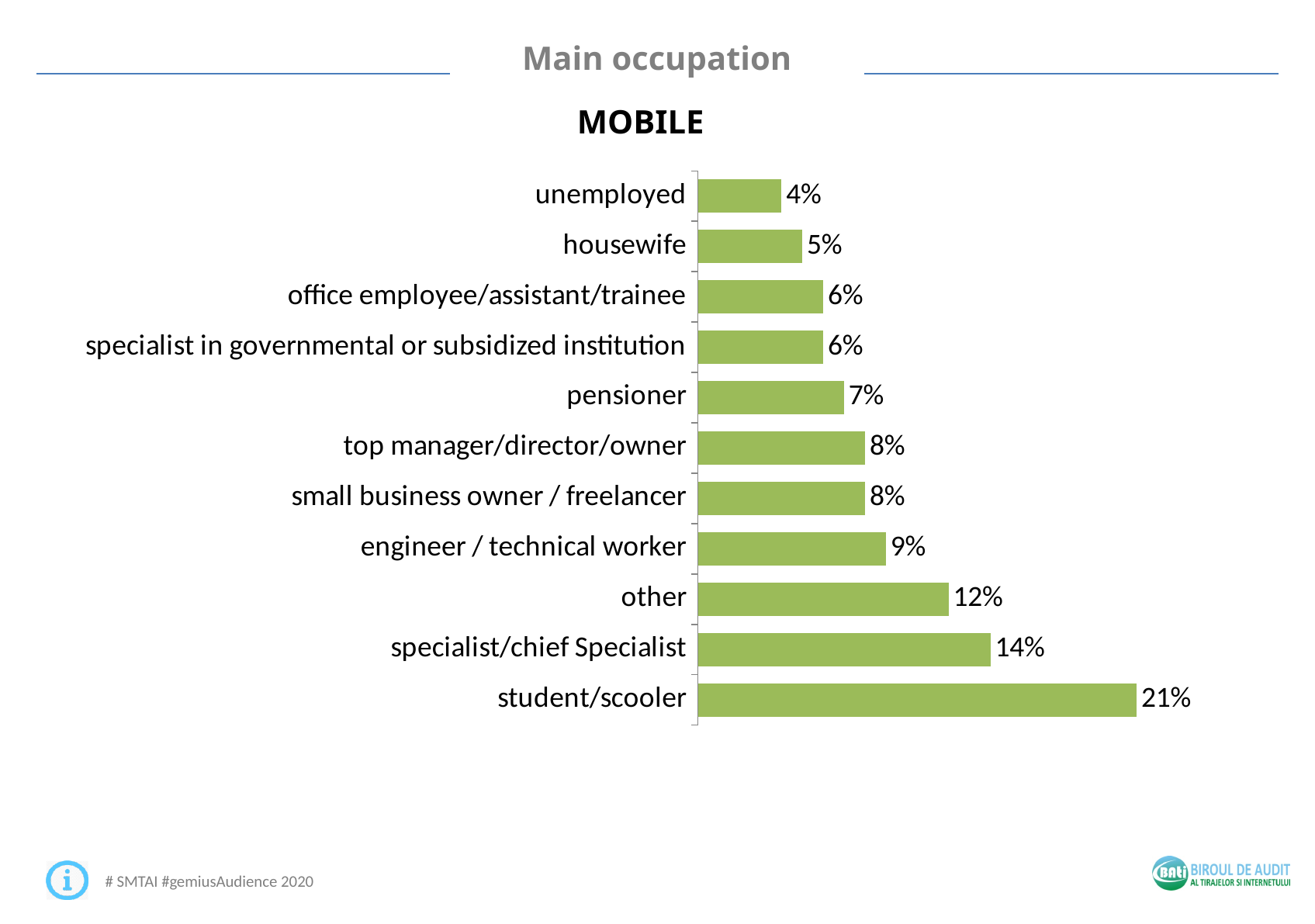
What kind of chart is shown on the slide? bar chart Which category has the highest value? student/scooler What is the value for pensioner? 7% What is the difference between the values for other and housewife? 7% Which is larger, the value for other or the value for engineer / technical worker? other What is the title shown above the chart? MOBILE Which category has the lowest value? unemployed How many categories are shown in the chart? 11 What is the value for engineer / technical worker? 9% What is the difference between the values for student/scooler and specialist/chief Specialist? 7% What is the value for student/scooler? 21% What is the value for specialist/chief Specialist? 14%